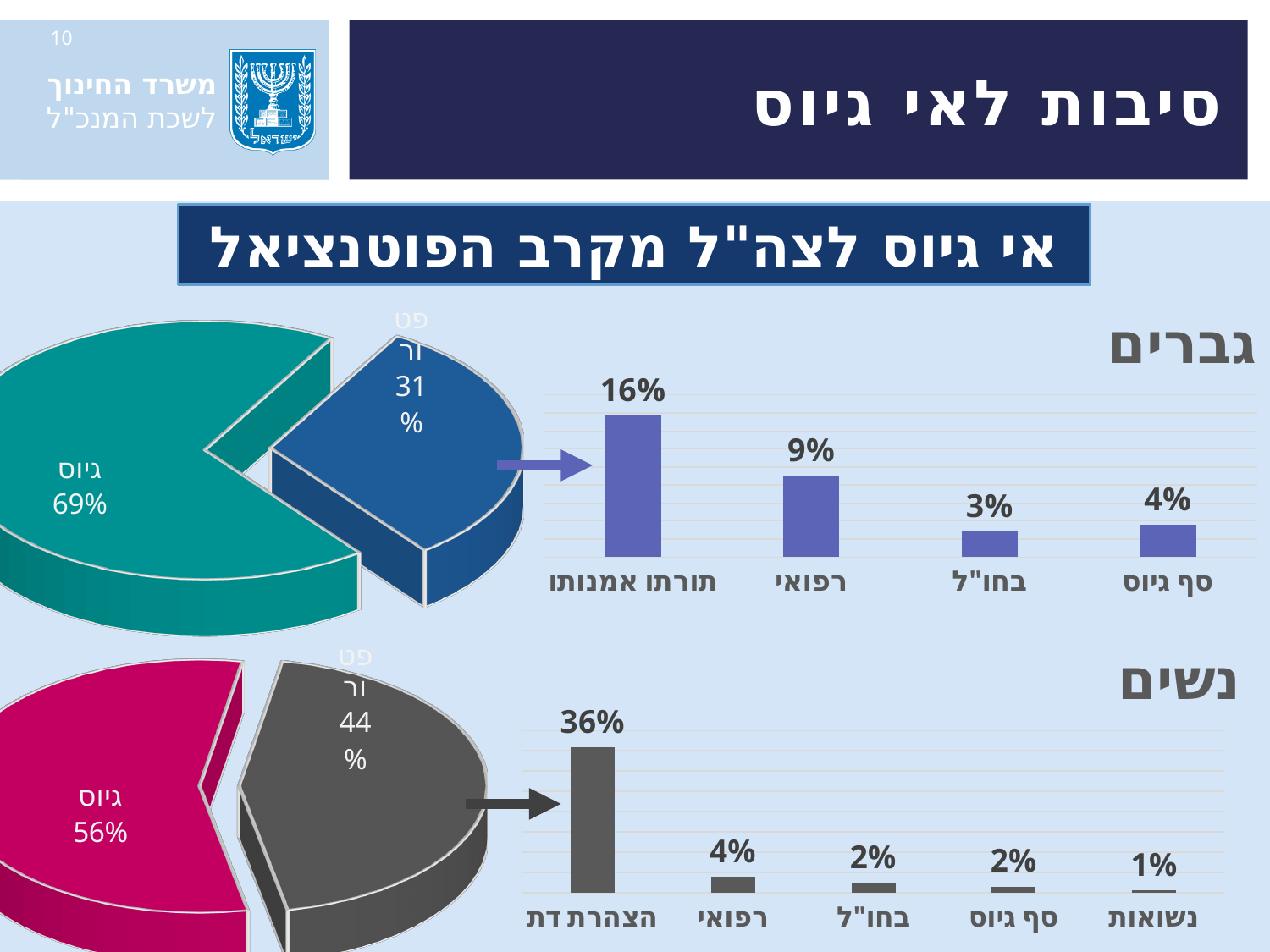
In the men's (גברים) bar chart, what is the value for תורתו אמנותו? 16% In the men's (גברים) pie chart, what share is labelled גיוס? 69% How many categories are shown in the women's (נשים) bar chart? 5 In the women's (נשים) pie chart, what share is labelled גיוס? 56% What kind of chart shows the גיוס and פטור shares for men (גברים)? Pie chart In the women's (נשים) bar chart, what is the value for נשואות? 1% In the men's (גברים) bar chart, which category has the lowest value? בחו"ל In the men's (גברים) pie chart, what share is labelled פטור? 31% In the women's (נשים) pie chart, what share is labelled פטור? 44% Which is larger: רפואי in the men's (גברים) bar chart or רפואי in the women's (נשים) bar chart? Men's (גברים) bar chart In the men's (גברים) bar chart, what is the difference between רפואי and סף גיוס? 5% In the women's (נשים) bar chart, which category has the highest value? הצהרת דת